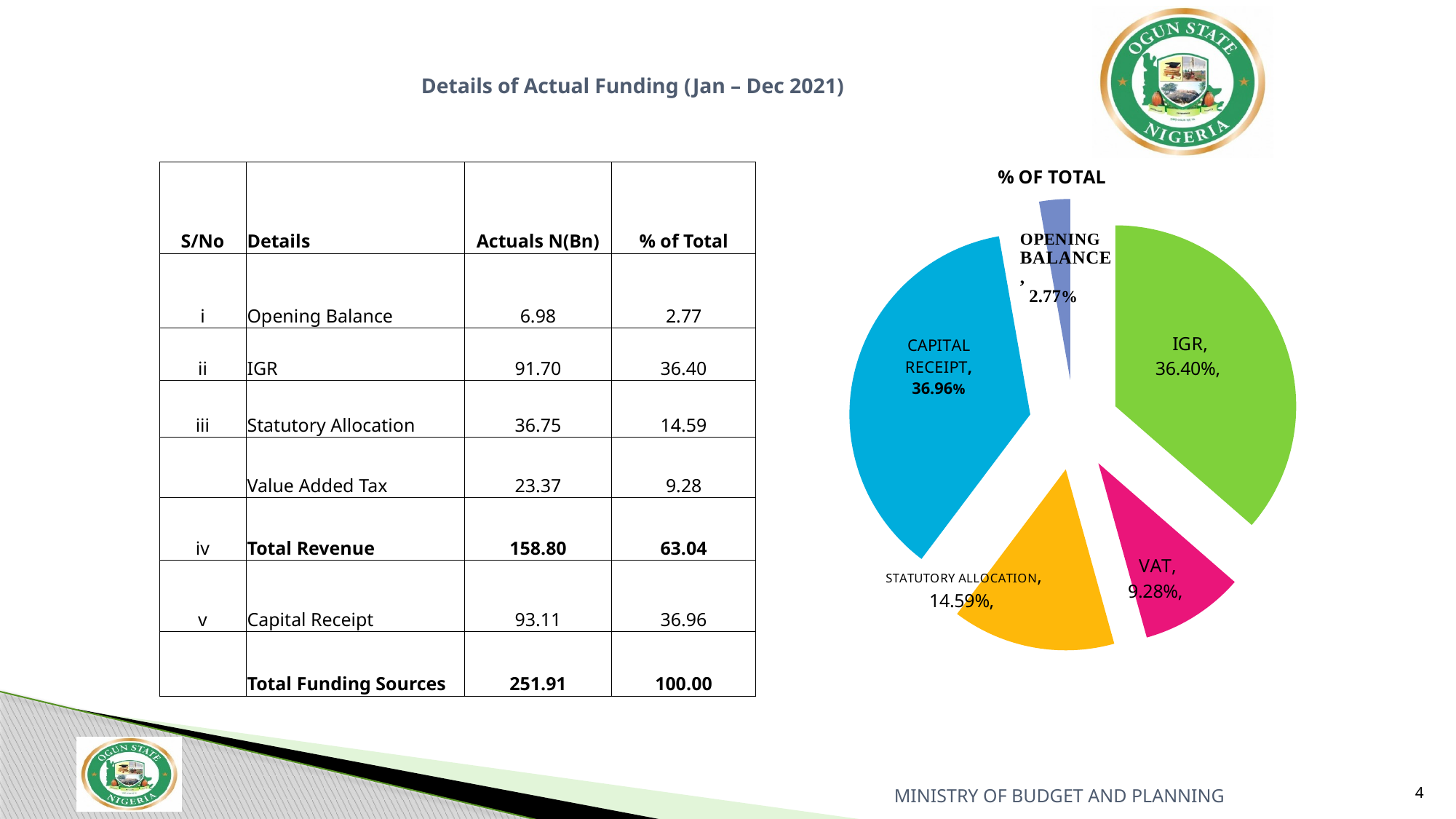
What kind of chart is shown on the slide? pie chart What share of the pie does Opening Balance represent? 2.77% Which slice of the pie chart is the smallest? Opening Balance Which is larger in the pie chart, the IGR slice or the Statutory Allocation slice? IGR What share of the pie does Statutory Allocation represent? 14.59% Which slice of the pie chart is the largest? Capital Receipt What share of the pie does Capital Receipt represent? 36.96% What is the difference in percentage points between the Statutory Allocation slice and the VAT slice? 5.31 How many slices does the pie chart have? 5 What is the title of the pie chart? % OF TOTAL